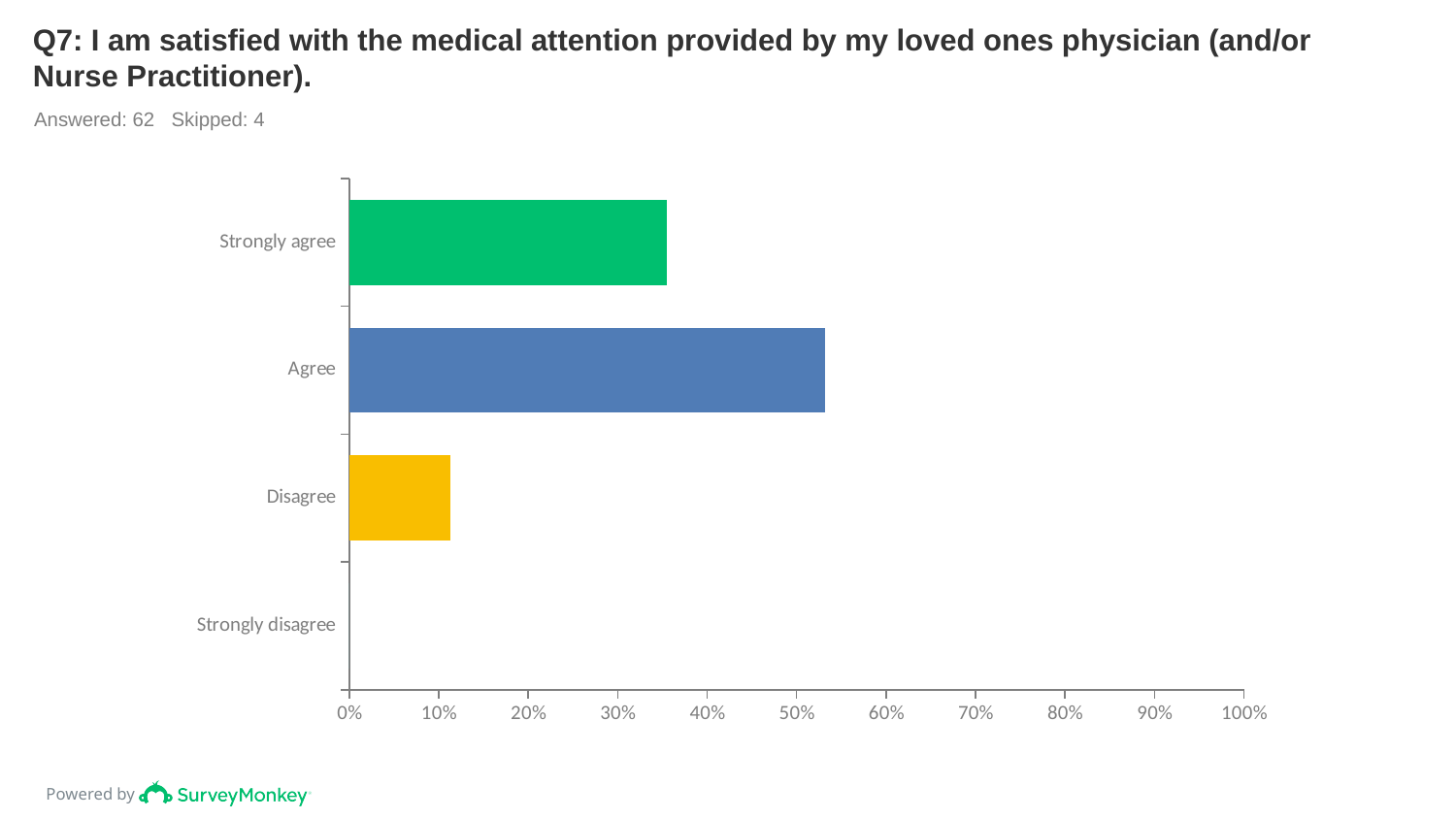
Is the value for Agree greater or less than 50%? greater Is the value for Strongly agree greater or less than 40%? less What is the value for Strongly disagree? 0% Which response category has the highest value? Agree Which response category has the lowest value? Strongly disagree What colour is the bar for Agree? blue Which is larger, the value for Strongly agree or the value for Disagree? Strongly agree How many response categories are shown on the chart? 4 Which is larger, the value for Strongly agree or the value for Agree? Agree What kind of chart is shown on the slide? bar chart Is the value for Disagree greater or less than 20%? less How many respondents answered this question according to the slide? 62